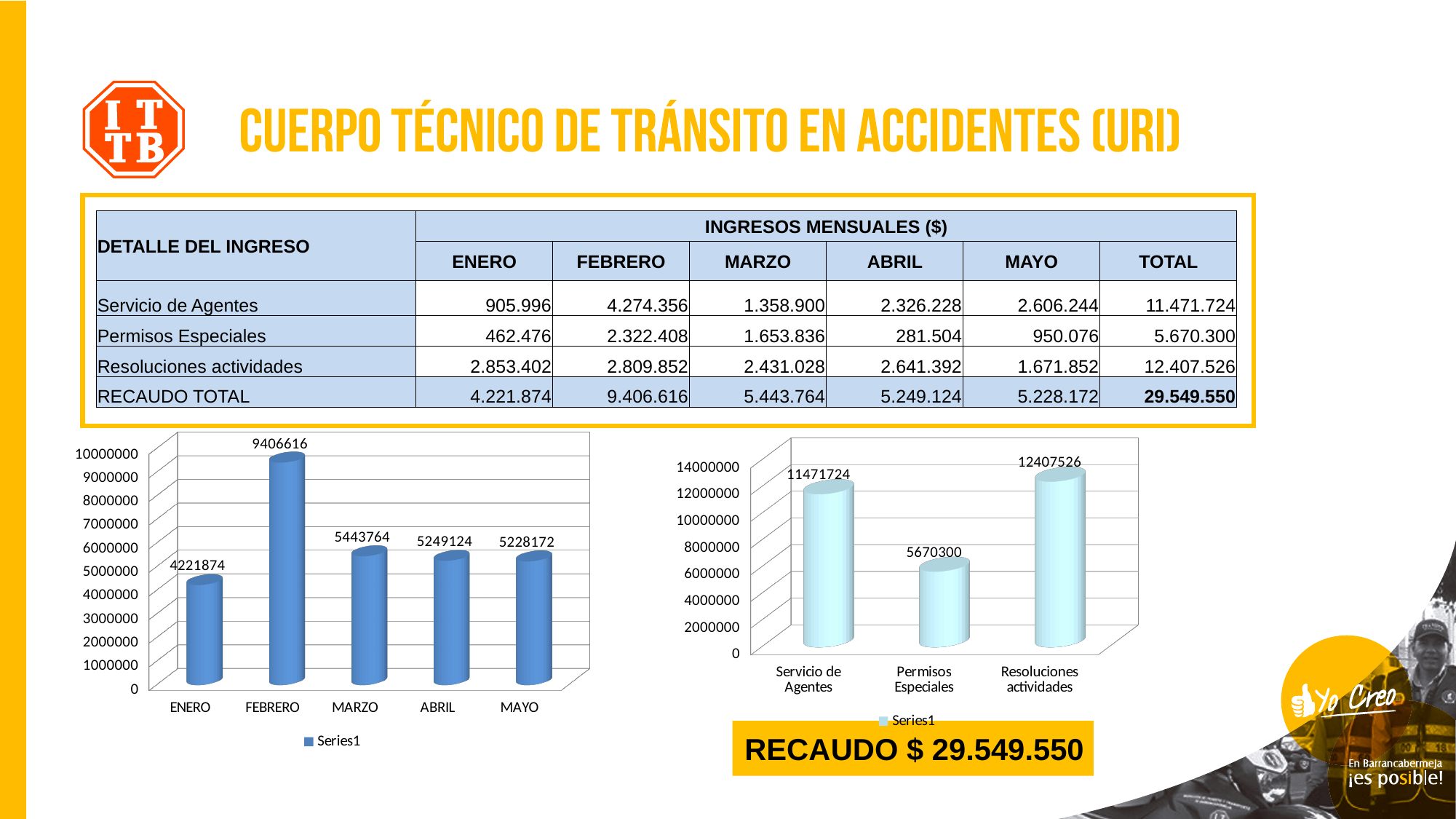
In the left chart (monthly totals), is the value for MARZO greater or less than 5000000? greater In the right chart (by income type), which is larger, Servicio de Agentes or Permisos Especiales? Servicio de Agentes What kind of chart is the right chart (by income type)? Bar chart In the left chart (monthly totals), how many months are plotted? 5 In the right chart (by income type), what is the value for Permisos Especiales? 5670300 In the right chart (by income type), which category has the highest value? Resoluciones actividades How many series does the legend of the left chart (monthly totals) list? 1 In the left chart (monthly totals), what is the difference between the values for FEBRERO and ENERO? 5184742 In the left chart (monthly totals), which month has the lowest value? ENERO In the left chart (monthly totals), what is the value for FEBRERO? 9406616 In the right chart (by income type), what is the difference between Resoluciones actividades and Servicio de Agentes? 935802 In the left chart (monthly totals), which month has the highest value? FEBRERO